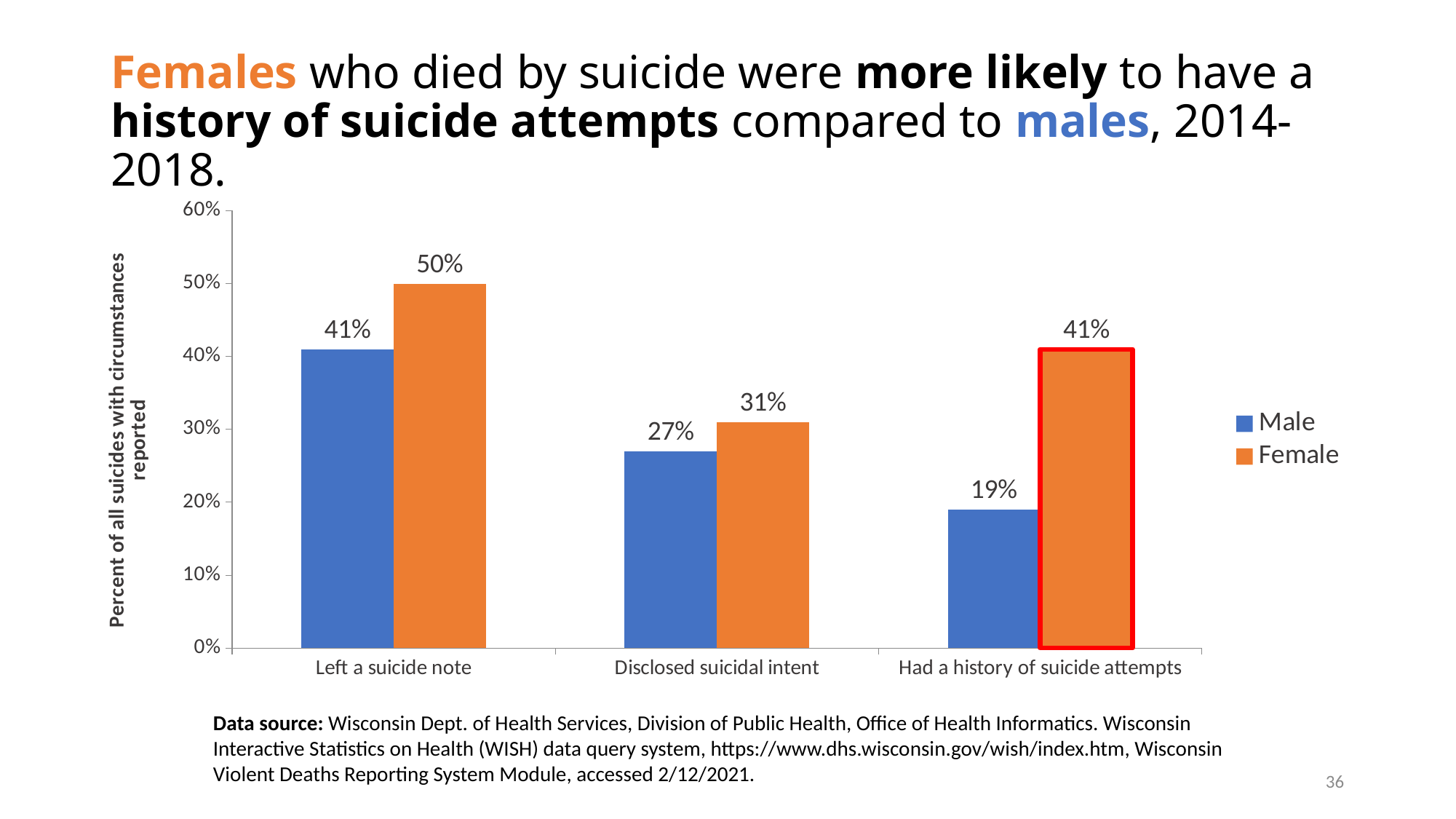
What is the difference between the Female and Male values for "Had a history of suicide attempts"? 22 percentage points Which category has the highest Female value? Left a suicide note Is the Male value for "Left a suicide note" greater or less than 40%? greater What is the Male value for "Disclosed suicidal intent"? 27% Which bar is outlined with a red box? Female, Had a history of suicide attempts What kind of chart is shown on the slide? Bar chart How many categories are shown on the x axis? 3 How many series does the legend list? 2 Which category has the lowest Male value? Had a history of suicide attempts Which is larger for "Disclosed suicidal intent": the Male value or the Female value? Female What is the Male value for "Had a history of suicide attempts"? 19% What is the Female value for "Left a suicide note"? 50%